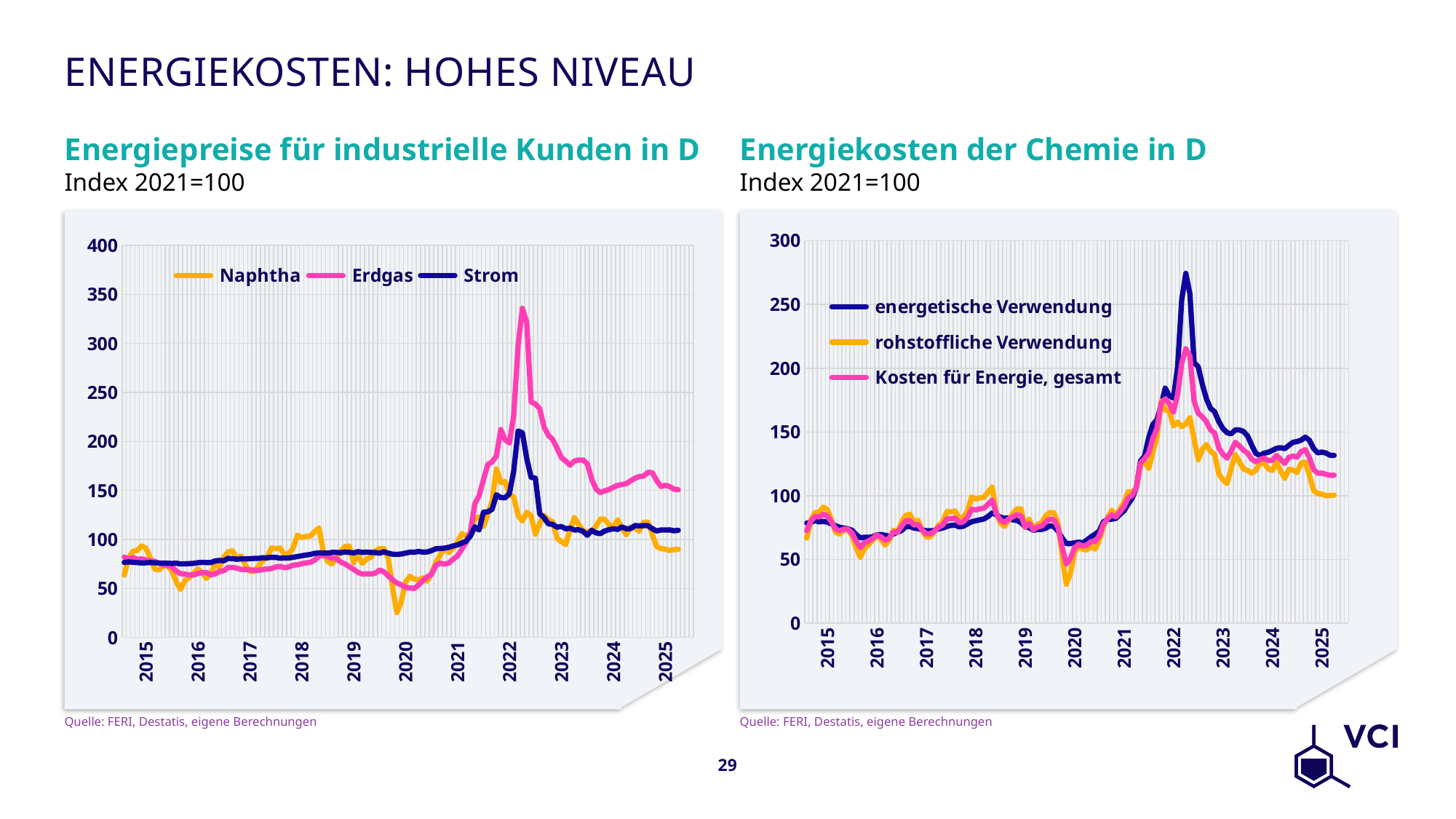
How many year labels are shown on the x axis of the 'Energiekosten der Chemie in D' chart? 11 In the 'Energiepreise für industrielle Kunden in D' chart, is the peak value of Erdgas in 2022 greater or less than 300? greater What kind of chart is the 'Energiepreise für industrielle Kunden in D' chart? line chart In the 'Energiepreise für industrielle Kunden in D' chart, is the value of Naphtha at the end of the series in 2025 greater or less than 100? less In the 'Energiekosten der Chemie in D' chart, which series reaches the highest peak? energetische Verwendung In the 'Energiepreise für industrielle Kunden in D' chart, does the Erdgas series rise or fall from its 2022 peak to 2025? fall How many series does the legend of the 'Energiepreise für industrielle Kunden in D' chart list? 3 In the 'Energiekosten der Chemie in D' chart, does the energetische Verwendung series rise or fall between 2020 and 2022? rise What index base is stated under the title of the 'Energiepreise für industrielle Kunden in D' chart? Index 2021=100 In the 'Energiekosten der Chemie in D' chart, is the peak value of energetische Verwendung in 2022 greater or less than 250? greater How many series does the legend of the 'Energiekosten der Chemie in D' chart list? 3 In the 'Energiepreise für industrielle Kunden in D' chart, which series reaches the highest peak? Erdgas